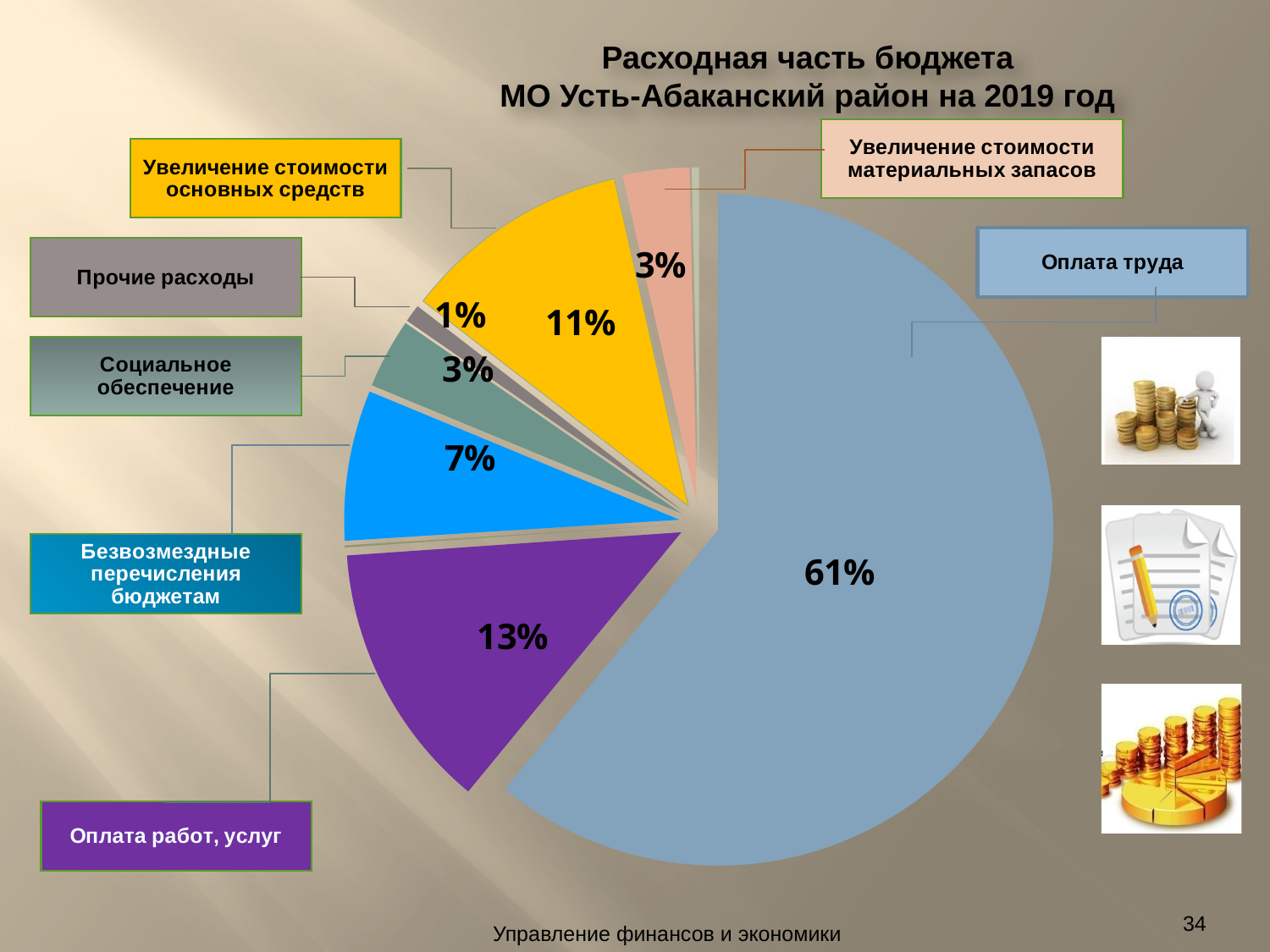
Which category has the largest share of the pie? Оплата труда What share of the budget expenditure is Прочие расходы? 1% What is the difference in percentage points between Оплата труда and Оплата работ, услуг? 48 What kind of chart is shown on the slide? pie chart What is the title of the chart? Расходная часть бюджета МО Усть-Абаканский район на 2019 год What share of the budget expenditure is Оплата труда? 61% Which is larger: Увеличение стоимости основных средств or Безвозмездные перечисления бюджетам? Увеличение стоимости основных средств What share of the budget expenditure is Увеличение стоимости основных средств? 11% How many slices does the pie chart have? 9